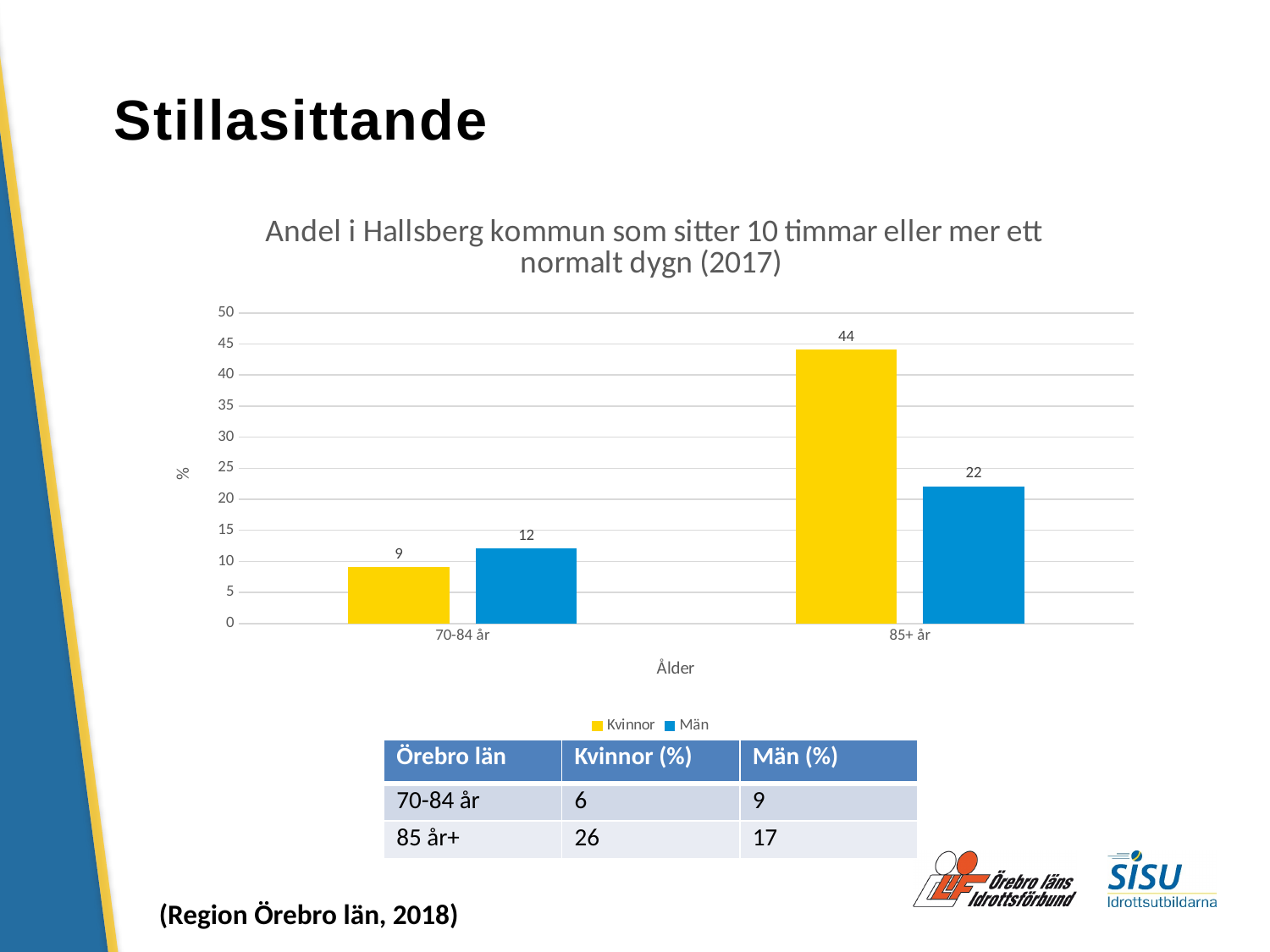
What is the difference between Kvinnor and Män in the 85+ år category? 22 What is the value for Kvinnor in the 85+ år category? 44 Which is larger in the 70-84 år category, Kvinnor or Män? Män What is the difference between Män and Kvinnor in the 70-84 år category? 3 What is the value for Män in the 70-84 år category? 12 Which bar has the lowest value in the chart? Kvinnor, 70-84 år How many series does the legend list? 2 What kind of chart is shown on the slide? Bar chart What is the value for Män in the 85+ år category? 22 What is the value for Kvinnor in the 70-84 år category? 9 How many age categories are shown on the x axis? 2 Which series has the highest value in the 85+ år category? Kvinnor